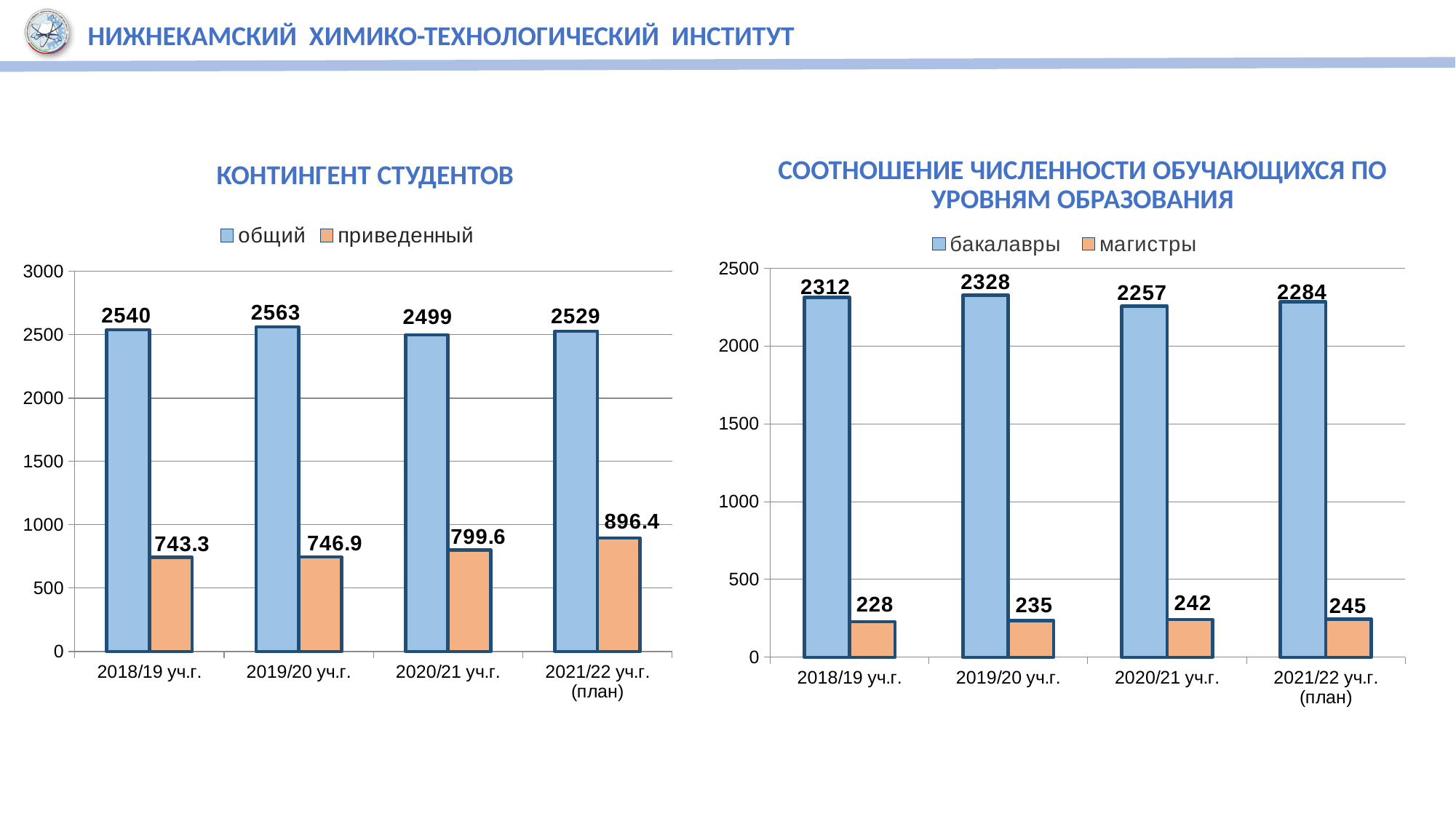
In the 'КОНТИНГЕНТ СТУДЕНТОВ' chart, do the 'приведенный' values rise or fall from 2018/19 to 2021/22? rise In the 'КОНТИНГЕНТ СТУДЕНТОВ' chart, what is the difference between the 'приведенный' values for 2020/21 уч.г. and 2019/20 уч.г.? 52.7 In the 'КОНТИНГЕНТ СТУДЕНТОВ' chart, what is the value of 'общий' for 2019/20 уч.г.? 2563 In the 'КОНТИНГЕНТ СТУДЕНТОВ' chart, what is the value of 'приведенный' for 2021/22 уч.г. (план)? 896.4 In the 'КОНТИНГЕНТ СТУДЕНТОВ' chart, which academic year has the lowest 'общий' value? 2020/21 уч.г. In the 'СООТНОШЕНИЕ ЧИСЛЕННОСТИ ОБУЧАЮЩИХСЯ ПО УРОВНЯМ ОБРАЗОВАНИЯ' chart, how many academic years are shown on the x axis? 4 In the 'СООТНОШЕНИЕ ЧИСЛЕННОСТИ ОБУЧАЮЩИХСЯ ПО УРОВНЯМ ОБРАЗОВАНИЯ' chart, what is the value of 'бакалавры' for 2020/21 уч.г.? 2257 In the 'СООТНОШЕНИЕ ЧИСЛЕННОСТИ ОБУЧАЮЩИХСЯ ПО УРОВНЯМ ОБРАЗОВАНИЯ' chart, what is the difference between 'бакалавры' and 'магистры' for 2021/22 уч.г. (план)? 2039 In the 'СООТНОШЕНИЕ ЧИСЛЕННОСТИ ОБУЧАЮЩИХСЯ ПО УРОВНЯМ ОБРАЗОВАНИЯ' chart, what is the value of 'магистры' for 2018/19 уч.г.? 228 In the 'КОНТИНГЕНТ СТУДЕНТОВ' chart, how many series does the legend list? 2 What type of chart is the 'СООТНОШЕНИЕ ЧИСЛЕННОСТИ ОБУЧАЮЩИХСЯ ПО УРОВНЯМ ОБРАЗОВАНИЯ' chart? bar chart In the 'СООТНОШЕНИЕ ЧИСЛЕННОСТИ ОБУЧАЮЩИХСЯ ПО УРОВНЯМ ОБРАЗОВАНИЯ' chart, which academic year has the highest 'бакалавры' value? 2019/20 уч.г.